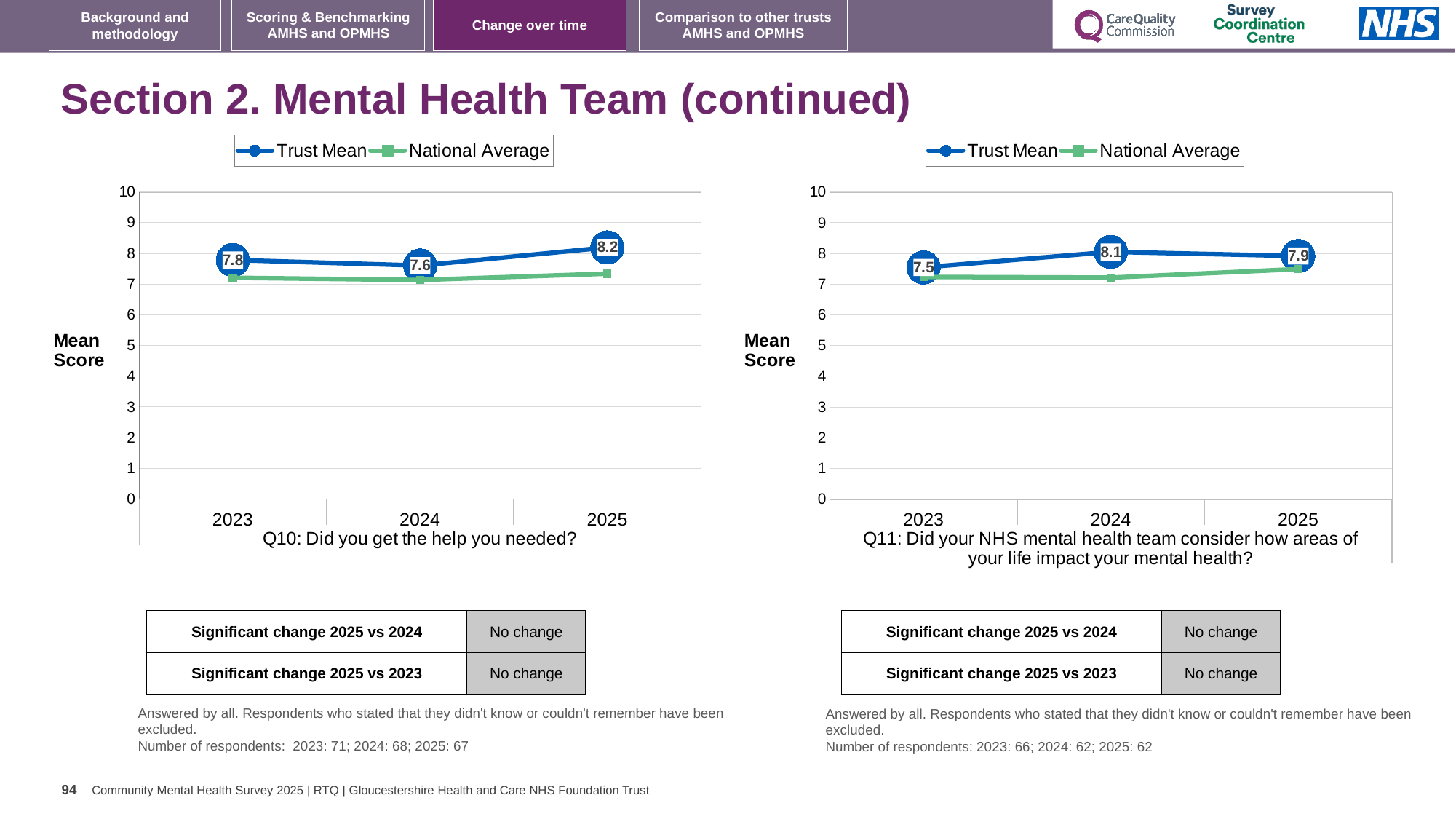
In the Q11 chart (right), is the Trust Mean higher in 2024 or in 2025? 2024 In the Q11 chart (right), which year has the lowest Trust Mean? 2023 How many years are shown on the x axis of the Q11 chart (right)? 3 In the Q11 chart (right), what is the Trust Mean for 2023? 7.5 How many series does the legend of the Q10 chart (left) list? 2 What type of chart is the Q11 chart (right)? Line chart In the Q10 chart (left), which year has the highest Trust Mean? 2025 In the Q11 chart (right), what is the Trust Mean for 2024? 8.1 In the Q10 chart (left), what is the difference between the Trust Mean in 2025 and in 2024? 0.6 In the Q10 chart (left), what is the Trust Mean for 2024? 7.6 In the Q10 chart (left), is the National Average for 2023 greater or less than 8? less In the Q10 chart (left), what is the Trust Mean for 2025? 8.2